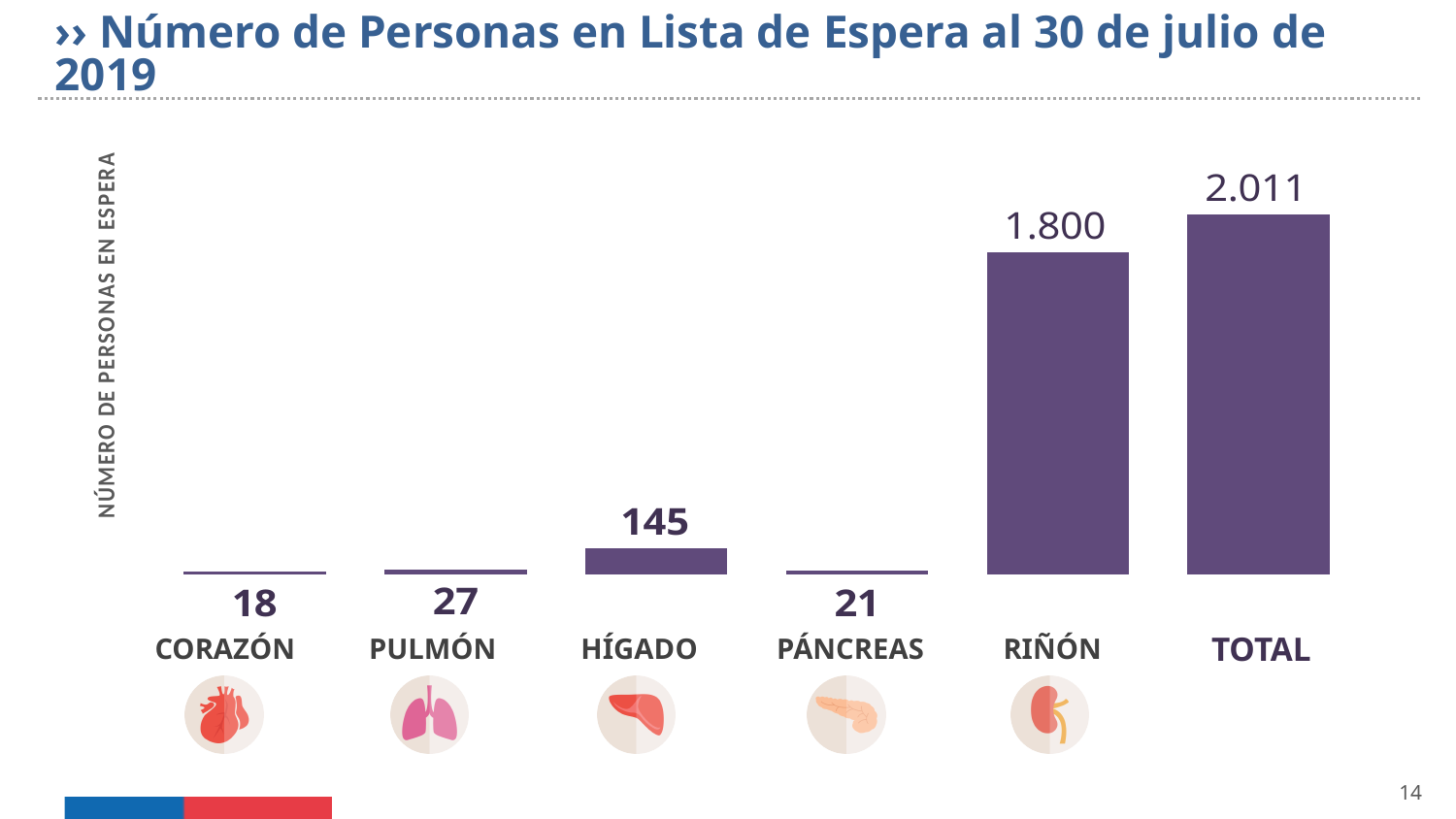
Which organ category (excluding TOTAL) has the highest number of people waiting? RIÑÓN What is the value shown for TOTAL? 2.011 Which category has the lowest number of people waiting? CORAZÓN What is the difference between the values for HÍGADO and PÁNCREAS? 124 How many categories are shown on the x axis, including TOTAL? 6 What is the label of the vertical axis? NÚMERO DE PERSONAS EN ESPERA What is the difference between the values for PULMÓN and CORAZÓN? 9 Which is larger, the value for PULMÓN or the value for PÁNCREAS? PULMÓN What is the value for RIÑÓN? 1.800 What is the value for CORAZÓN? 18 What kind of chart is shown on the slide? Bar chart What is the value for HÍGADO? 145